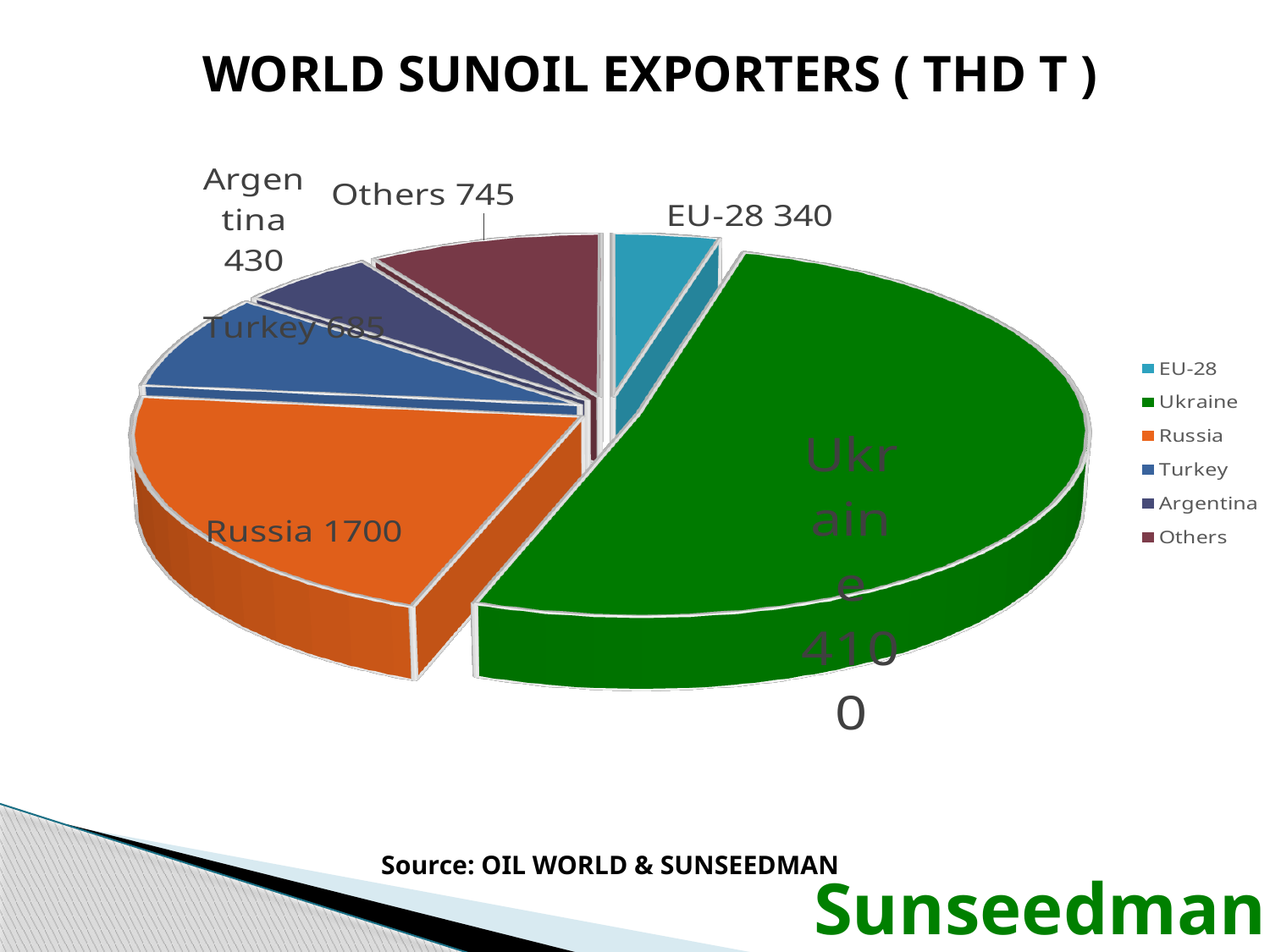
What share of the pie does Russia represent? 21.25% What is the value for Russia in the World Sunoil Exporters chart? 1700 Which is larger, the value for Turkey or the value for Argentina? Turkey What is the value for Others in the World Sunoil Exporters chart? 745 What type of chart is shown on the slide? Pie chart What is the value for EU-28 in the World Sunoil Exporters chart? 340 What is the title of the chart? WORLD SUNOIL EXPORTERS ( THD T ) How many slices does the pie chart have? 6 What is the difference between the values for Ukraine and Russia? 2400 Which exporter has the smallest slice in the pie chart? EU-28 What is the value for Argentina in the World Sunoil Exporters chart? 430 Which exporter has the largest slice in the pie chart? Ukraine